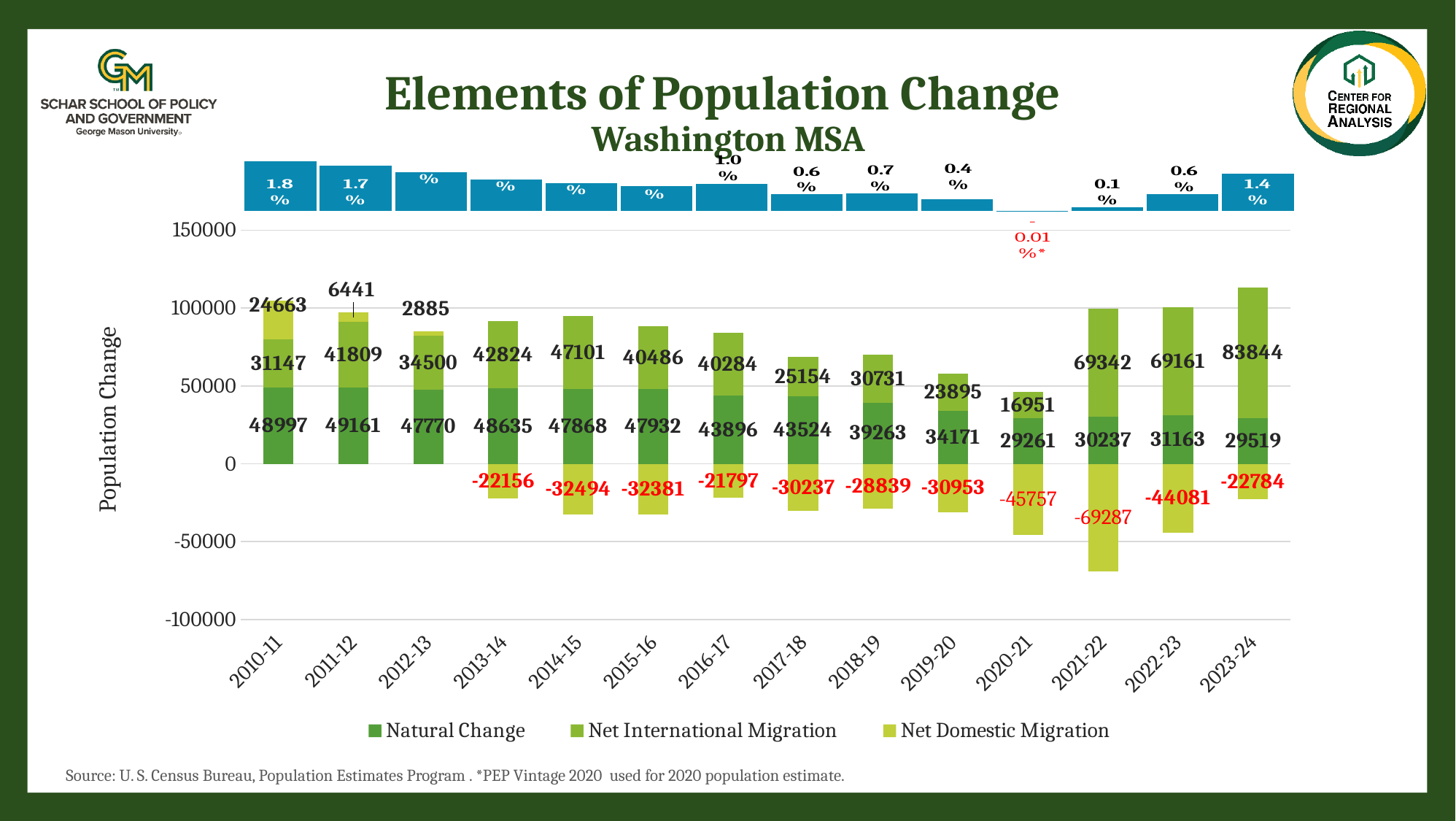
What kind of chart is shown on the slide? Stacked bar chart Which year has the larger Net International Migration, 2014-15 or 2015-16? 2014-15 In which year is Net Domestic Migration lowest (most negative)? 2021-22 What is the difference between the Natural Change values for 2010-11 and 2023-24? 19478 What is the total of the three components for 2010-11? 104807 What is the Net International Migration value for 2023-24? 83844 What is the Natural Change value for 2020-21? 29261 In which year is Net International Migration highest? 2023-24 How many year categories are shown on the x axis? 14 Does Natural Change generally rise or fall from 2010-11 to 2023-24? Fall What is the Net Domestic Migration value for 2021-22? -69287 How many series does the legend list? 3